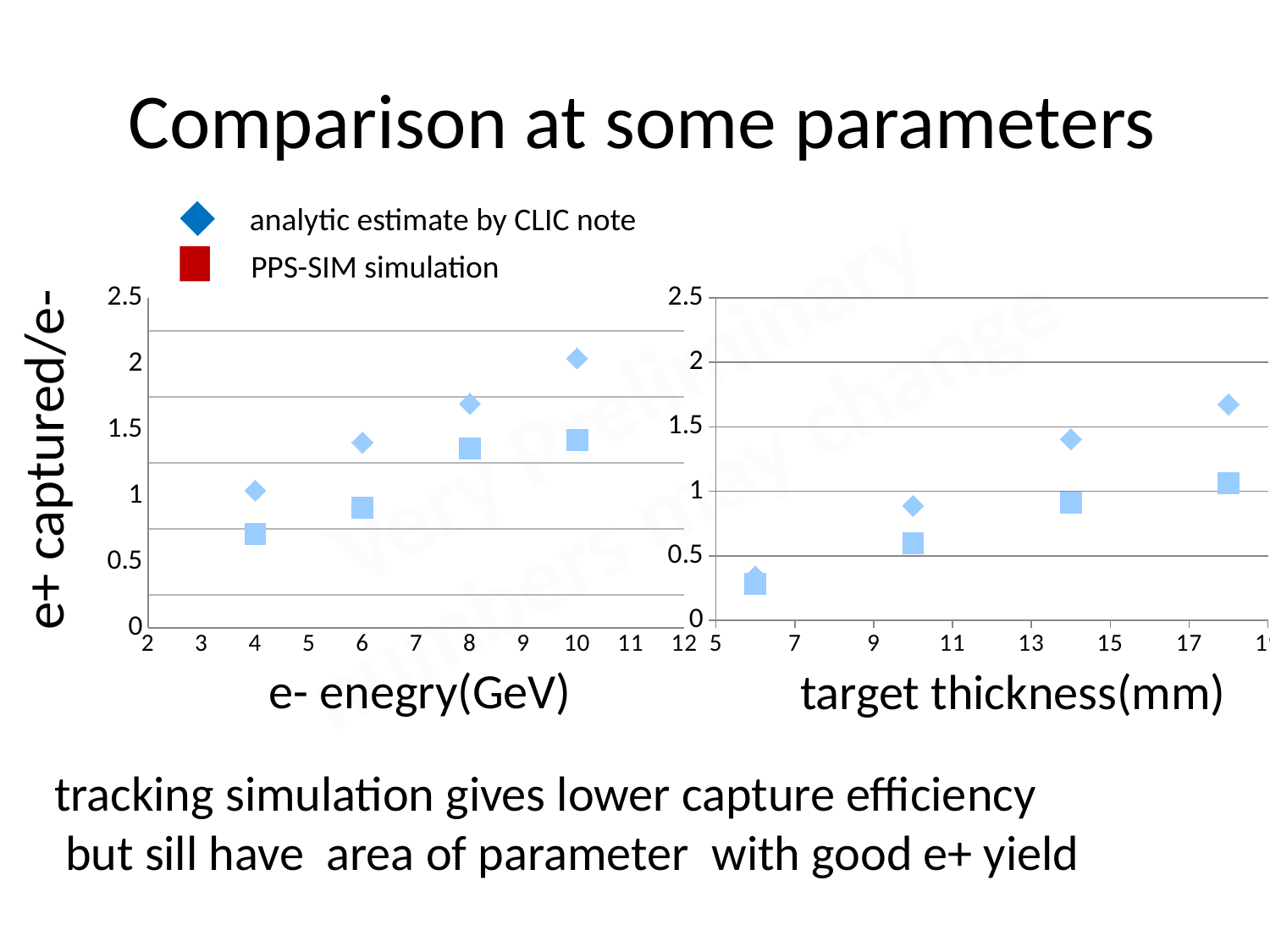
In the left chart (e- energy), at 8 GeV, which series has the larger value: analytic estimate by CLIC note or PPS-SIM simulation? analytic estimate by CLIC note In the right chart (target thickness), do the PPS-SIM simulation values rise or fall as target thickness increases? rise In the left chart (e- energy), is the PPS-SIM simulation value at 4 GeV greater or less than 1? less In the right chart (target thickness), is the PPS-SIM simulation value at 10 mm greater or less than 1? less In the left chart (e- energy), do the analytic estimate values rise or fall as e- energy increases? rise In the left chart (e- energy), is the analytic estimate value at 10 GeV greater or less than 1.5? greater What is the x-axis label of the right chart? target thickness(mm) What kind of chart is the left chart (e- energy)? scatter chart How many series does the legend list? 2 In the left chart, at which e- energy is the analytic estimate highest? 10 GeV In the left chart (e- energy), how many data points does the analytic estimate series have? 4